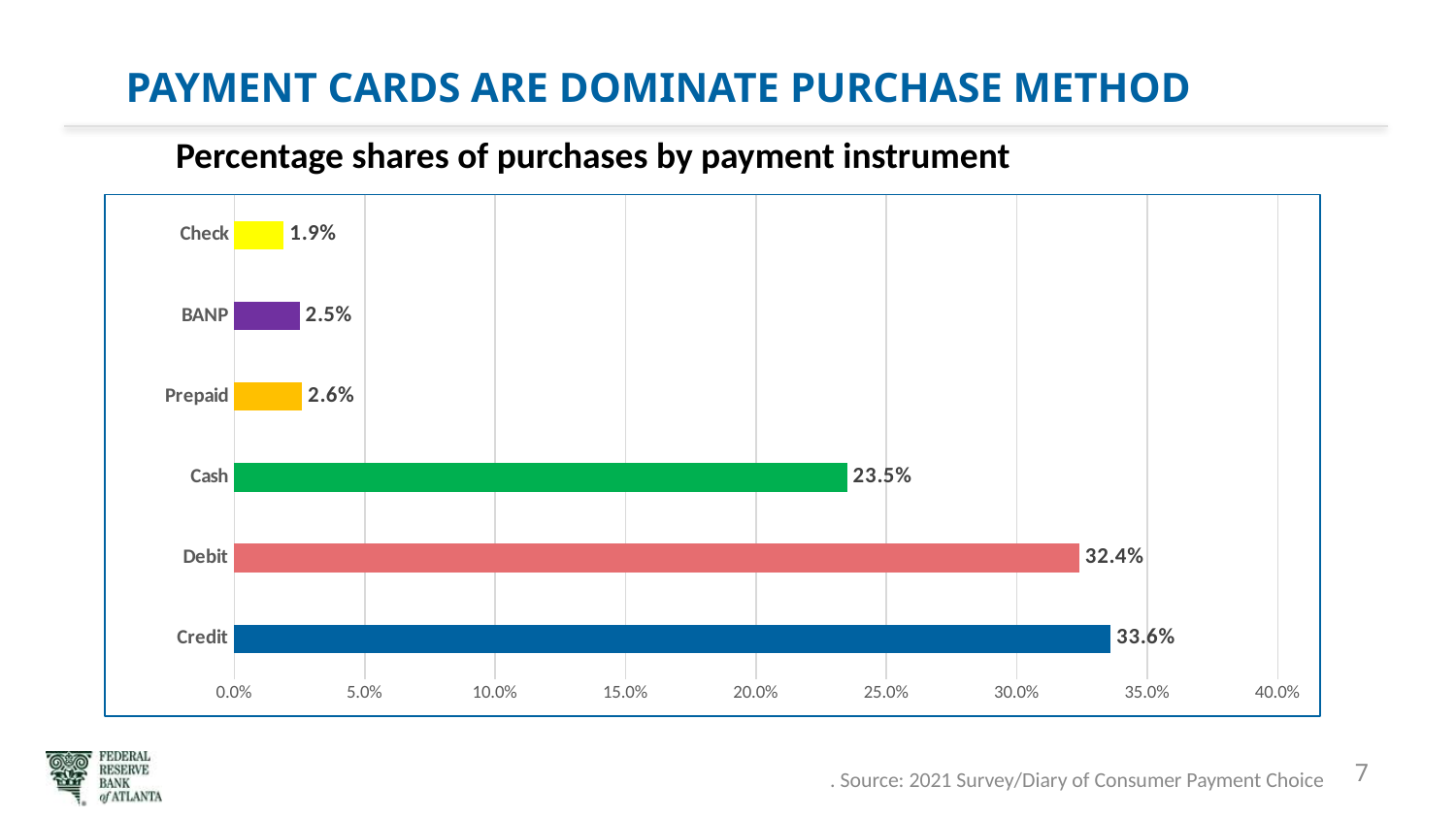
Which payment instrument has the lowest share of purchases? Check Is the value for Cash greater or less than 25.0%? less What is the difference in percentage points between the Credit and Debit shares? 1.2 Which payment instrument has the highest share of purchases? Credit What is the percentage share of purchases made by Credit? 33.6% What is the title of the chart? Percentage shares of purchases by payment instrument What is the difference in percentage points between the Debit and Cash shares? 8.9 What kind of chart is shown on the slide? Bar chart How many payment instruments are shown in the chart? 6 What is the percentage share of purchases made by Check? 1.9% Which has a larger share of purchases, Cash or Debit? Debit What is the percentage share of purchases made by Cash? 23.5%